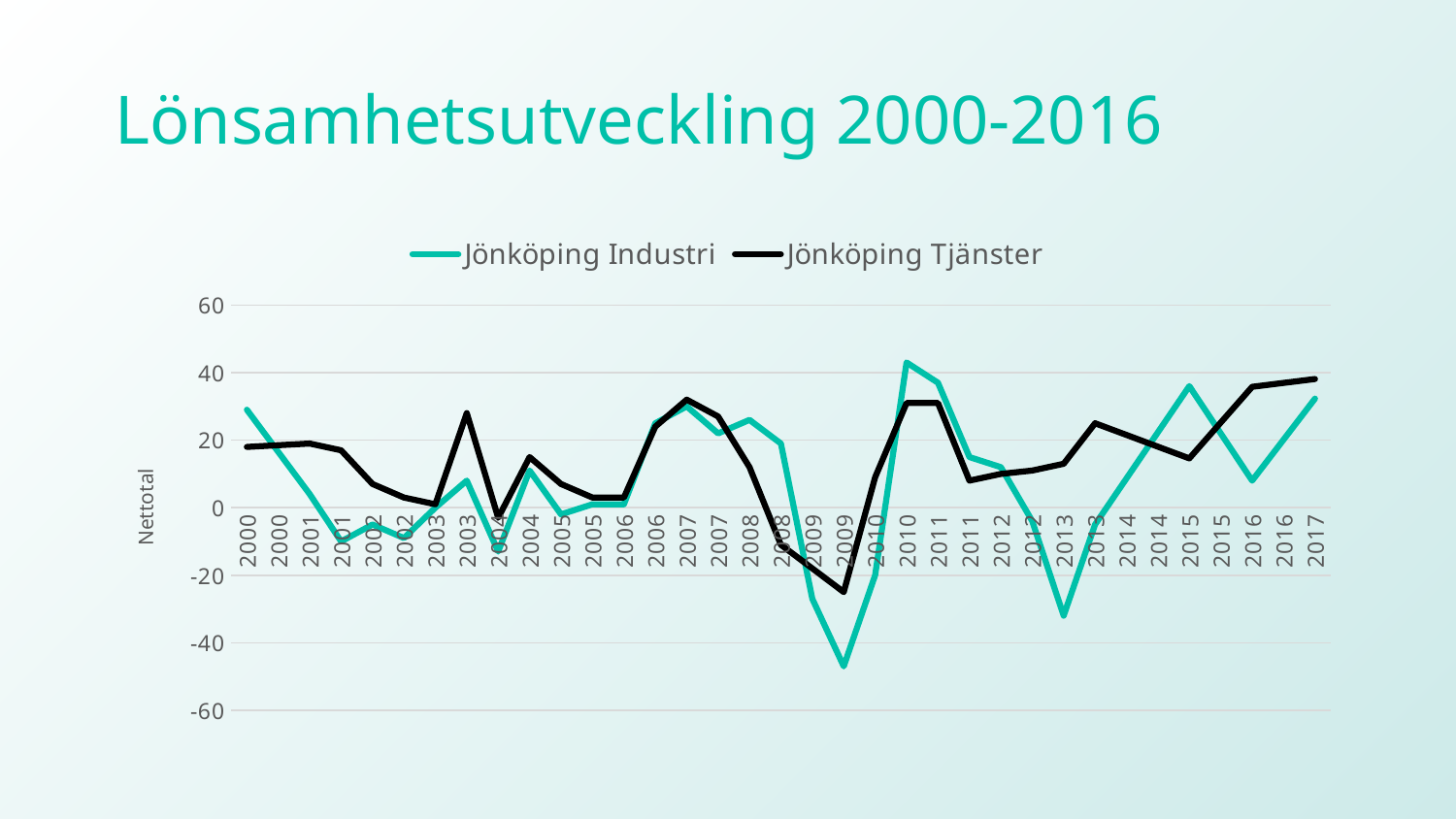
What is the label on the vertical axis of the chart? Nettotal Is the value of the Jönköping Tjänster line at 2017 greater or less than 20? greater What is the title of the chart on the slide? Lönsamhetsutveckling 2000-2016 At the low point in 2009, which series has the lower value, Jönköping Industri or Jönköping Tjänster? Jönköping Industri In which year does the Jönköping Industri line reach its lowest value? 2009 What kind of chart is shown on the slide? line chart In which year does the Jönköping Industri line reach its highest value? 2010 Is the lowest value of the Jönköping Tjänster line (in 2009) greater or less than -20? less Is the lowest value of the Jönköping Industri line (in 2009) greater or less than -40? less How many series does the legend list? 2